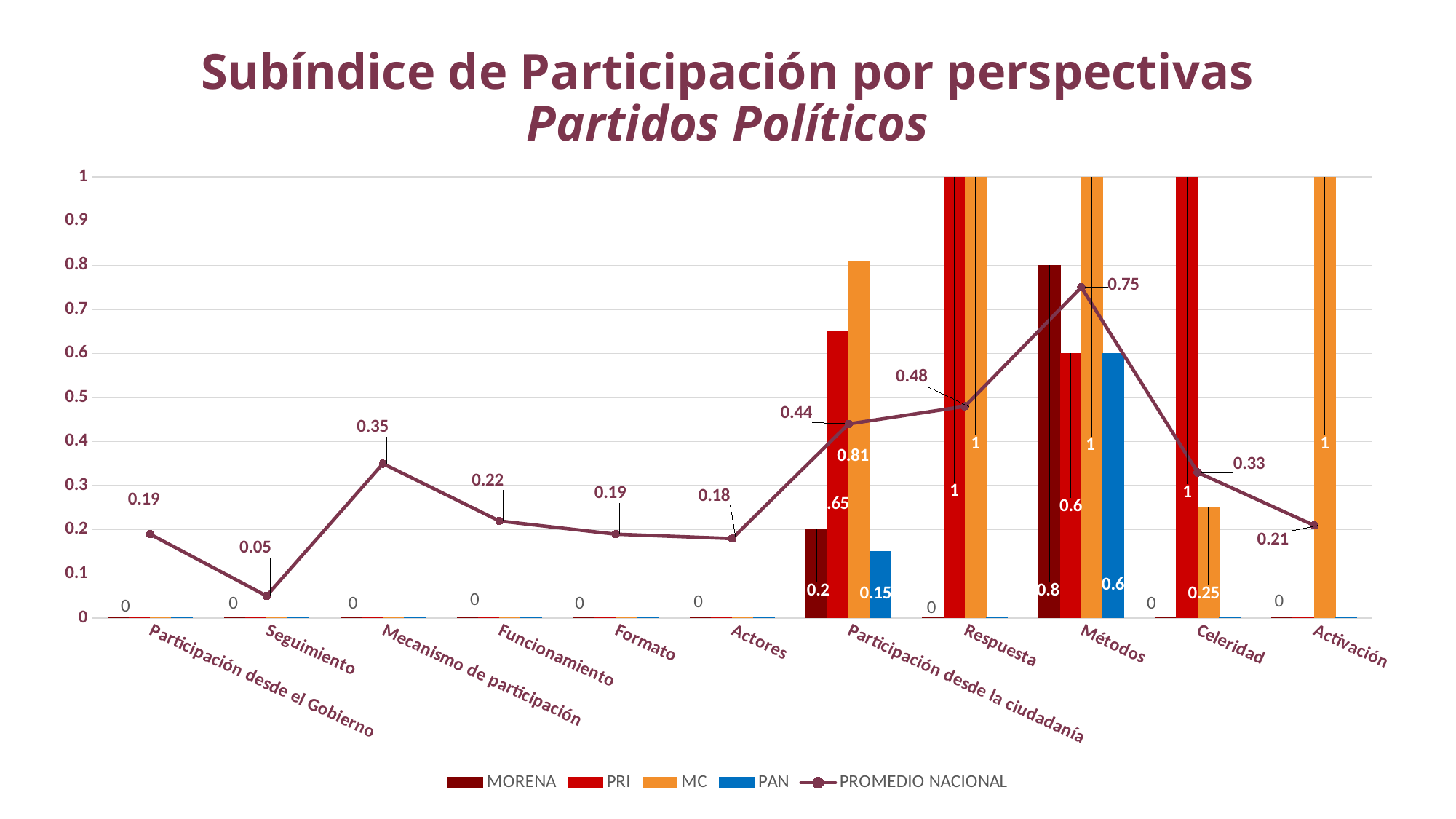
How many series does the legend list? 5 Does the PROMEDIO NACIONAL line rise or fall from Métodos to Activación? fall In Participación desde la ciudadanía, which is larger, the PRI value or the MC value? MC What is the PAN value for Métodos? 0.6 What is the difference between the PROMEDIO NACIONAL values for Métodos and Seguimiento? 0.7 What is the PROMEDIO NACIONAL value for Mecanismo de participación? 0.35 Which category has the lowest PROMEDIO NACIONAL value? Seguimiento What kind of chart is shown on the slide? Combined bar and line chart Which category has the highest PROMEDIO NACIONAL value? Métodos How many categories are shown on the x axis? 11 Is the MORENA value for Métodos greater or less than 0.5? greater What is the MC value for Participación desde la ciudadanía? 0.81